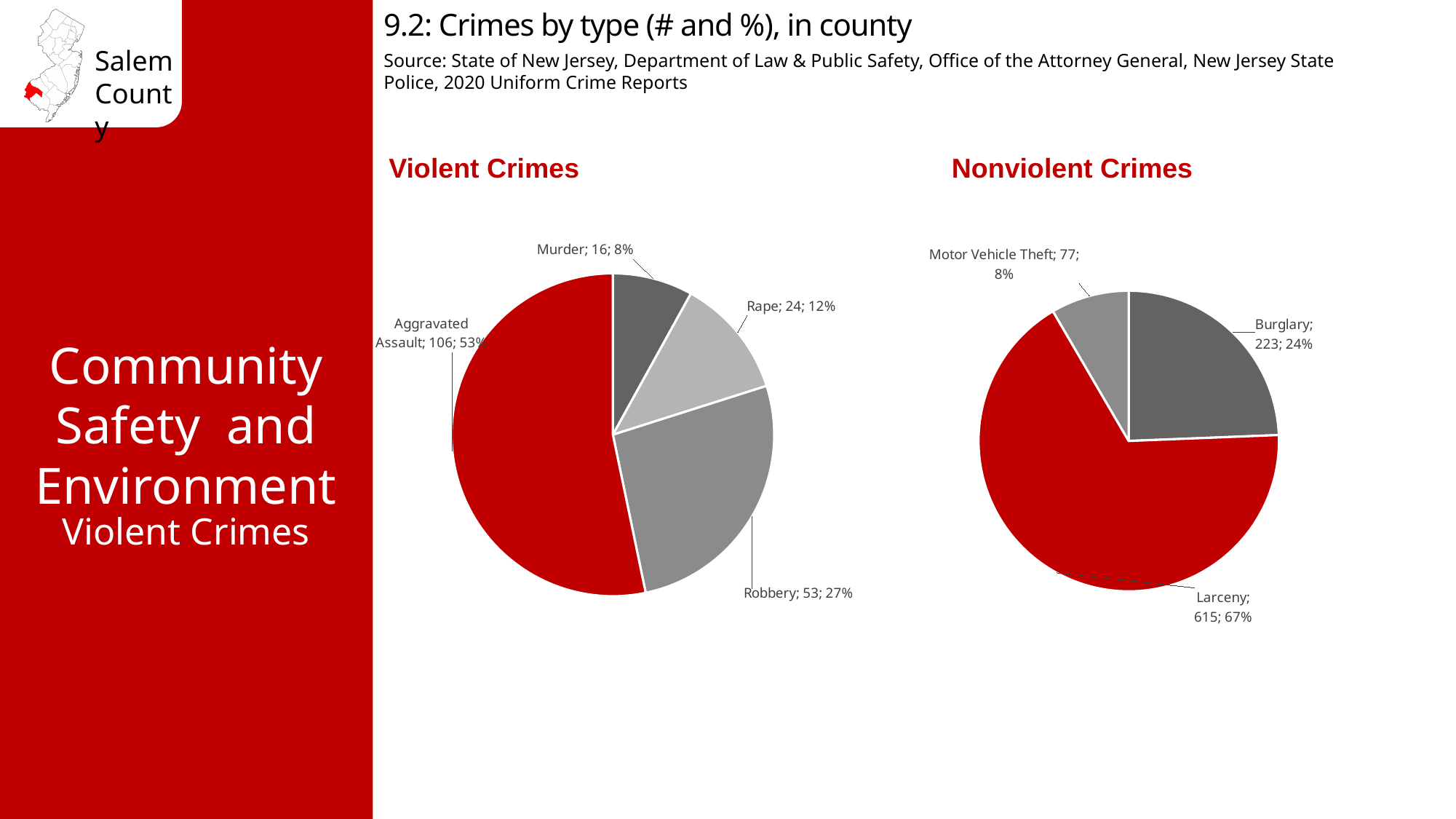
In the Nonviolent Crimes chart, how many larcenies are shown? 615 In the Violent Crimes chart, what share of the pie is Robbery? 27% Which is larger: the number of murders in the Violent Crimes chart or the number of motor vehicle thefts in the Nonviolent Crimes chart? Motor Vehicle Theft In the Nonviolent Crimes chart, which crime type has the smallest slice? Motor Vehicle Theft In the Violent Crimes chart, which crime type has the smallest slice? Murder In the Nonviolent Crimes chart, what share of the pie is Burglary? 24% In the Violent Crimes chart, which crime type has the largest slice? Aggravated Assault In the Violent Crimes chart, how many aggravated assaults are shown? 106 In the Violent Crimes chart, what is the difference between the number of robberies and the number of rapes? 29 What kind of chart is the Nonviolent Crimes chart? Pie chart In the Violent Crimes chart, how many crime categories are shown? 4 In the Nonviolent Crimes chart, what is the difference between the number of burglaries and the number of motor vehicle thefts? 146